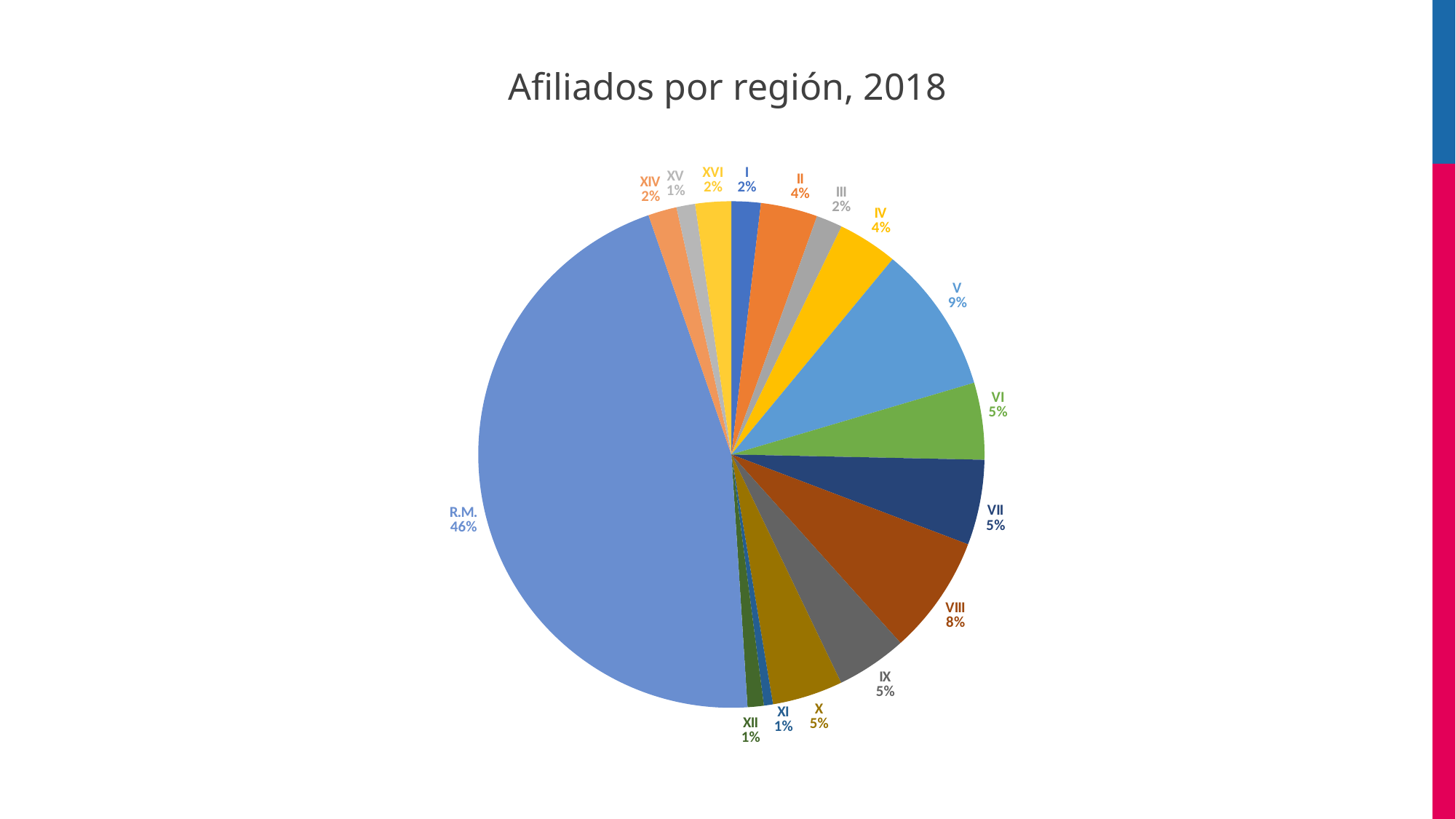
Which is larger, the slice for region V or the slice for region VI? V What is the combined share of regions XI and XII? 2% What is the value shown for region V? 9% What is the value shown for region VIII? 8% What is the title of the chart? Afiliados por región, 2018 How many slices does the pie chart have? 16 What kind of chart is shown on the slide? Pie chart What is the value shown for region XIV? 2% What share of the pie does R.M. represent? 46% What is the difference between the share for R.M. and the share for region V? 37% What is the difference between the share for region VIII and the share for region II? 4% Which region has the largest slice of the pie? R.M.